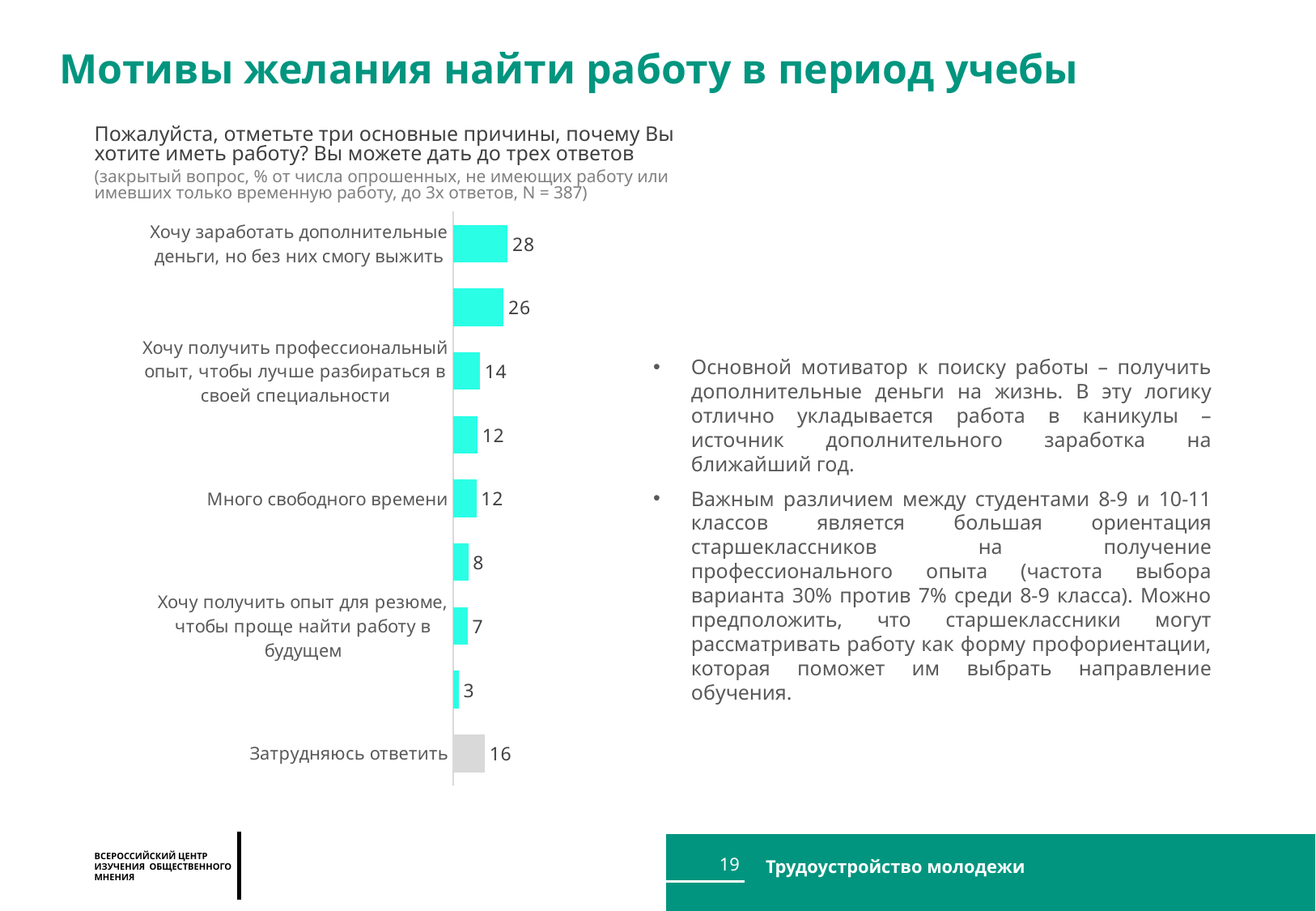
How many bars are plotted on the chart? 9 What value is shown for «Хочу заработать дополнительные деньги, но без них смогу выжить»? 28 What kind of chart is shown on the slide? Bar chart Which is larger: the value for «Много свободного времени» or for «Хочу получить опыт для резюме, чтобы проще найти работу в будущем»? Много свободного времени What value is shown for «Хочу получить опыт для резюме, чтобы проще найти работу в будущем»? 7 What value is shown for «Хочу получить профессиональный опыт, чтобы лучше разбираться в своей специальности»? 14 What is the difference between the values for «Хочу заработать дополнительные деньги, но без них смогу выжить» and «Затрудняюсь ответить»? 12 What value is shown for «Много свободного времени»? 12 What value is shown for «Затрудняюсь ответить»? 16 What is the smallest value shown on the chart? 3 Which bar on the chart is coloured grey rather than turquoise? Затрудняюсь ответить Which labelled category has the highest value on the chart? Хочу заработать дополнительные деньги, но без них смогу выжить